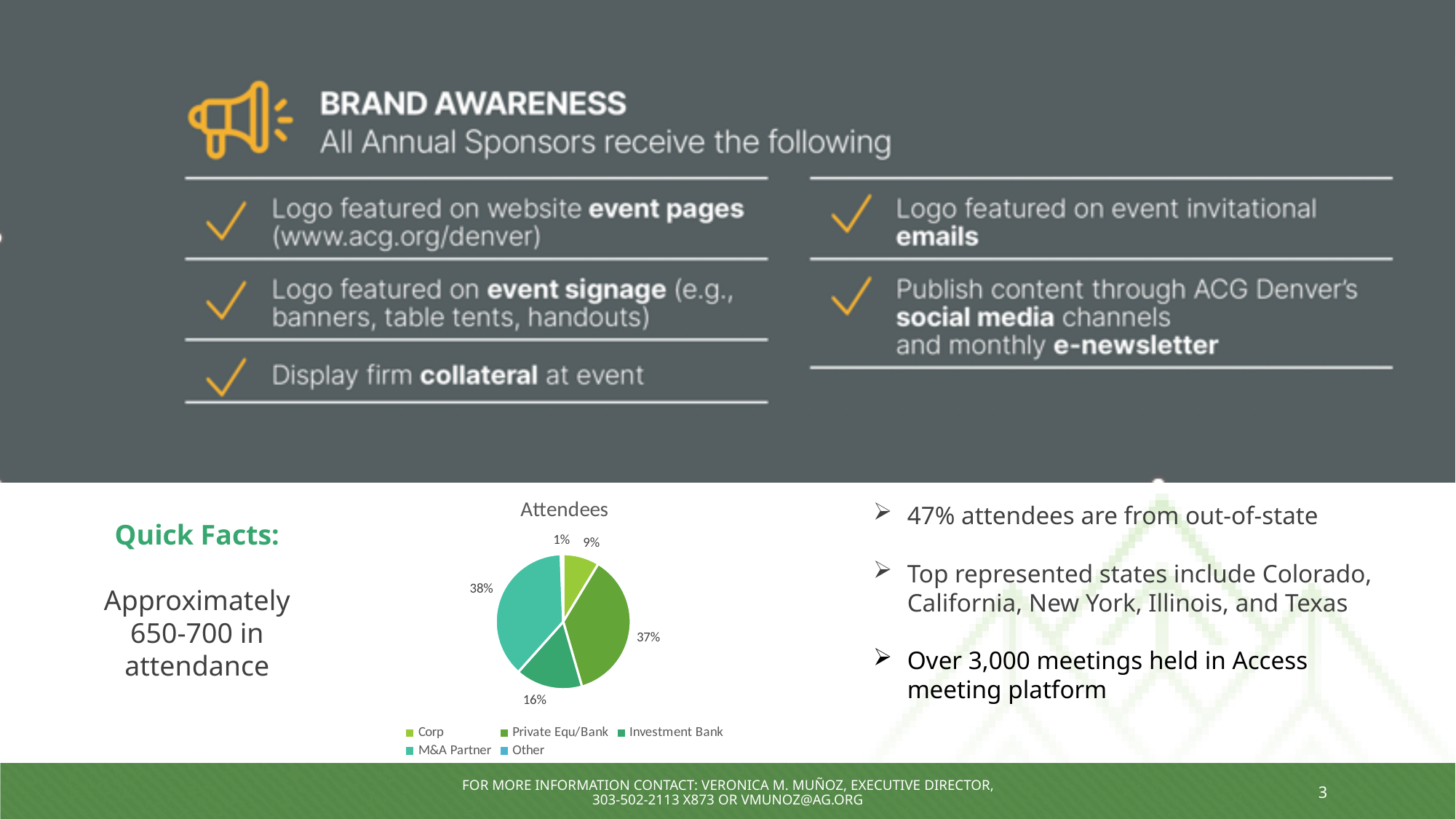
In the Attendees pie chart, what share of attendees are Corp? 9% In the Attendees pie chart, what share of attendees are Private Equ/Bank? 37% In the Attendees pie chart, what is the difference in percentage points between M&A Partner and Investment Bank? 22 In the Attendees pie chart, what share of attendees are Other? 1% In the Attendees pie chart, what share of attendees are M&A Partner? 38% How many categories does the legend of the Attendees pie chart list? 5 In the Attendees pie chart, what share of attendees are Investment Bank? 16% In the Attendees pie chart, which is larger: Investment Bank or Corp? Investment Bank What kind of chart is shown under the Quick Facts section? Pie chart What is the title of the pie chart on the slide? Attendees Which category has the largest slice in the Attendees pie chart? M&A Partner Which category has the smallest slice in the Attendees pie chart? Other